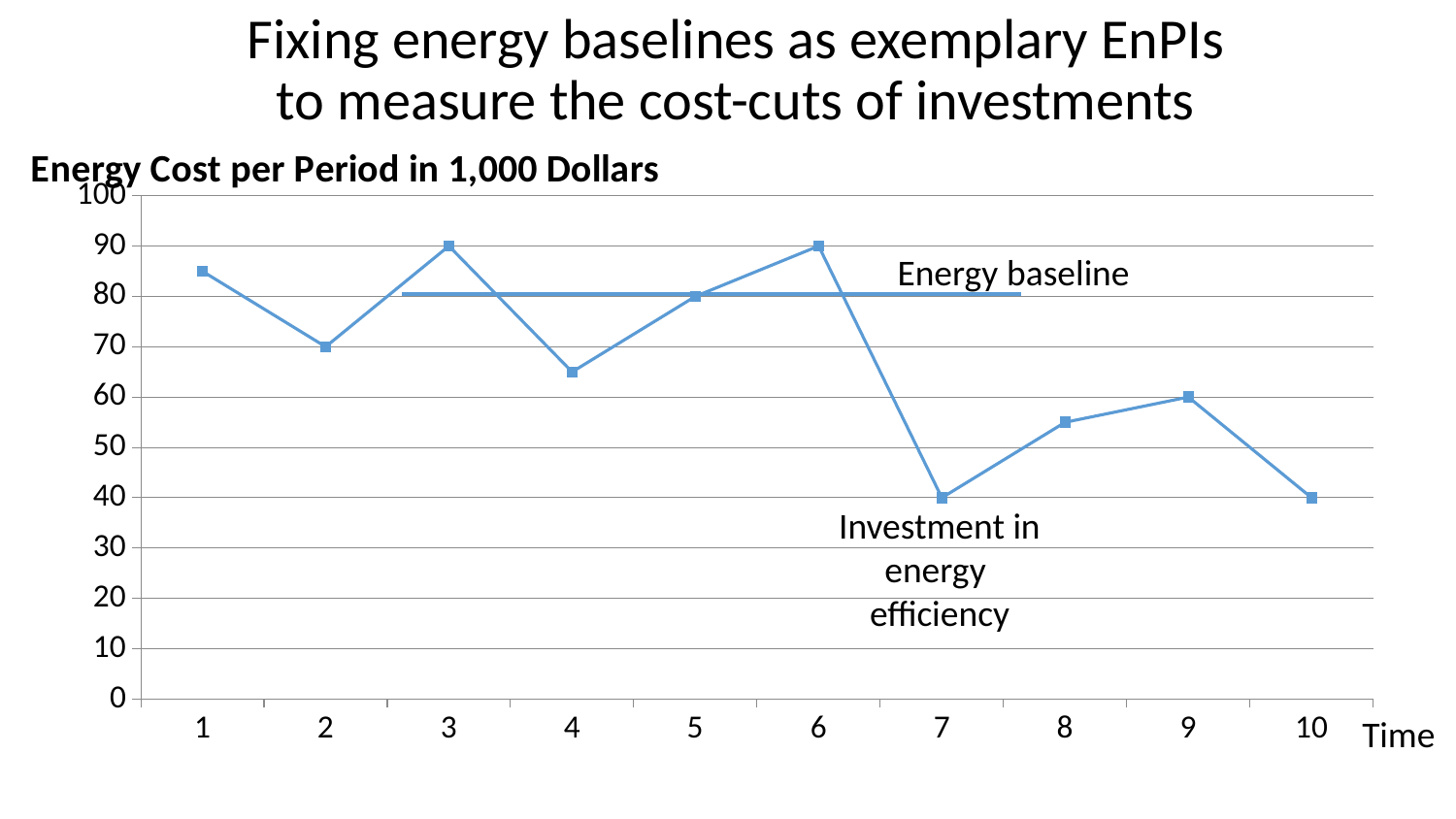
At what value is the horizontal line labelled 'Energy baseline' drawn? 80 What kind of chart is shown on the slide? line chart What is the energy cost at time 3? 90 Is the energy cost at time 8 greater or less than 50? greater Is the energy cost at time 4 greater or less than 70? less How many time periods are plotted on the x axis? 10 What is the energy cost at time 9? 60 Is the energy cost at time 1 greater or less than 80? greater What is the difference between the energy cost at time 3 and at time 7? 50 Does the energy cost rise or fall from time 6 to time 7? fall Which has the higher energy cost, time 2 or time 9? time 2 What is the energy cost at time 7? 40